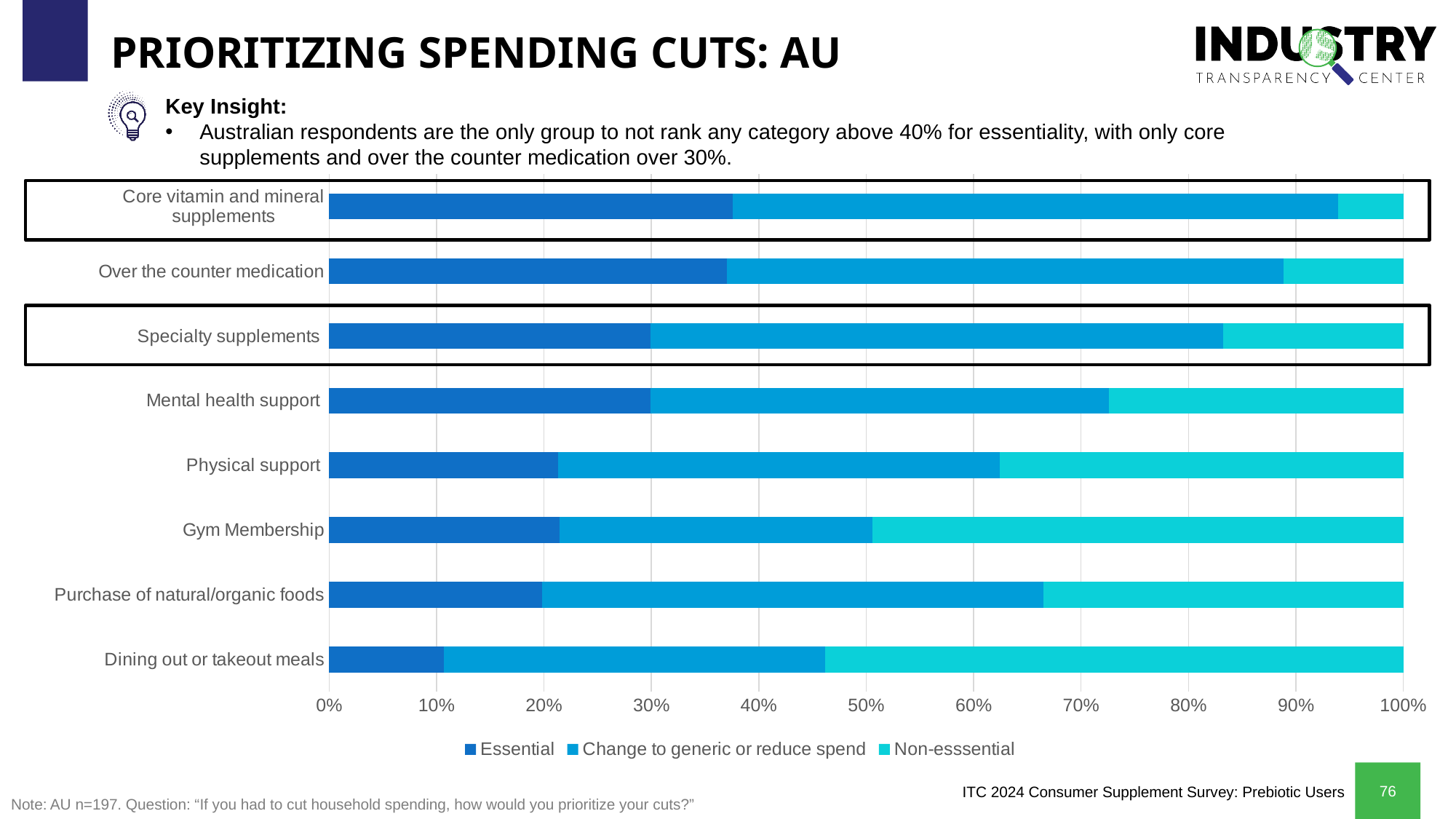
Is the Essential value for Core vitamin and mineral supplements greater or less than 30%? greater How many series does the chart legend list? 3 Which category has the largest Non-esssential share? Dining out or takeout meals How many categories are plotted on the chart? 8 Is the Essential value for Dining out or takeout meals greater or less than 20%? less Which category has the lowest Essential share? Dining out or takeout meals Which has a larger Essential share: Over the counter medication or Gym Membership? Over the counter medication Is the Essential value for Physical support greater or less than 30%? less What kind of chart is shown on the slide? Stacked bar chart What is the title of the slide containing the chart? PRIORITIZING SPENDING CUTS: AU What is the total of the stacked bar for Gym Membership? 100% Which category has the highest Essential share? Core vitamin and mineral supplements